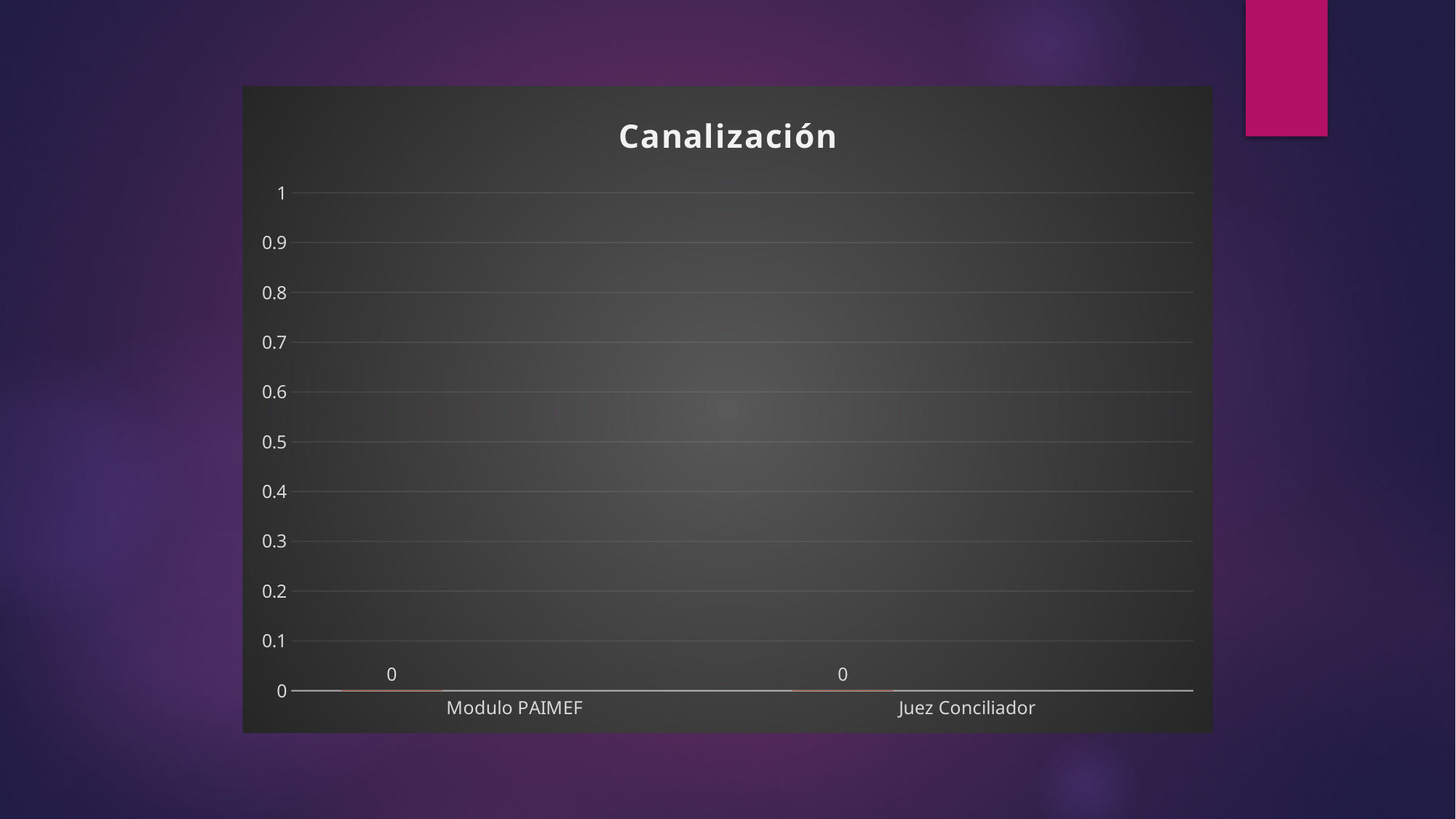
Is the value for Modulo PAIMEF in the Canalización chart greater or less than 0.5? less What kind of chart is the Canalización chart? bar chart What is the difference between the values for Modulo PAIMEF and Juez Conciliador in the Canalización chart? 0 What is the value for Juez Conciliador in the Canalización chart? 0 What is the value for Modulo PAIMEF in the Canalización chart? 0 Is the value for Juez Conciliador in the Canalización chart greater or less than 0.1? less Which category is listed first on the x axis of the Canalización chart? Modulo PAIMEF How many categories are shown on the x axis of the Canalización chart? 2 What is the title of the chart on the slide? Canalización What is the highest value shown on the y axis of the Canalización chart? 1